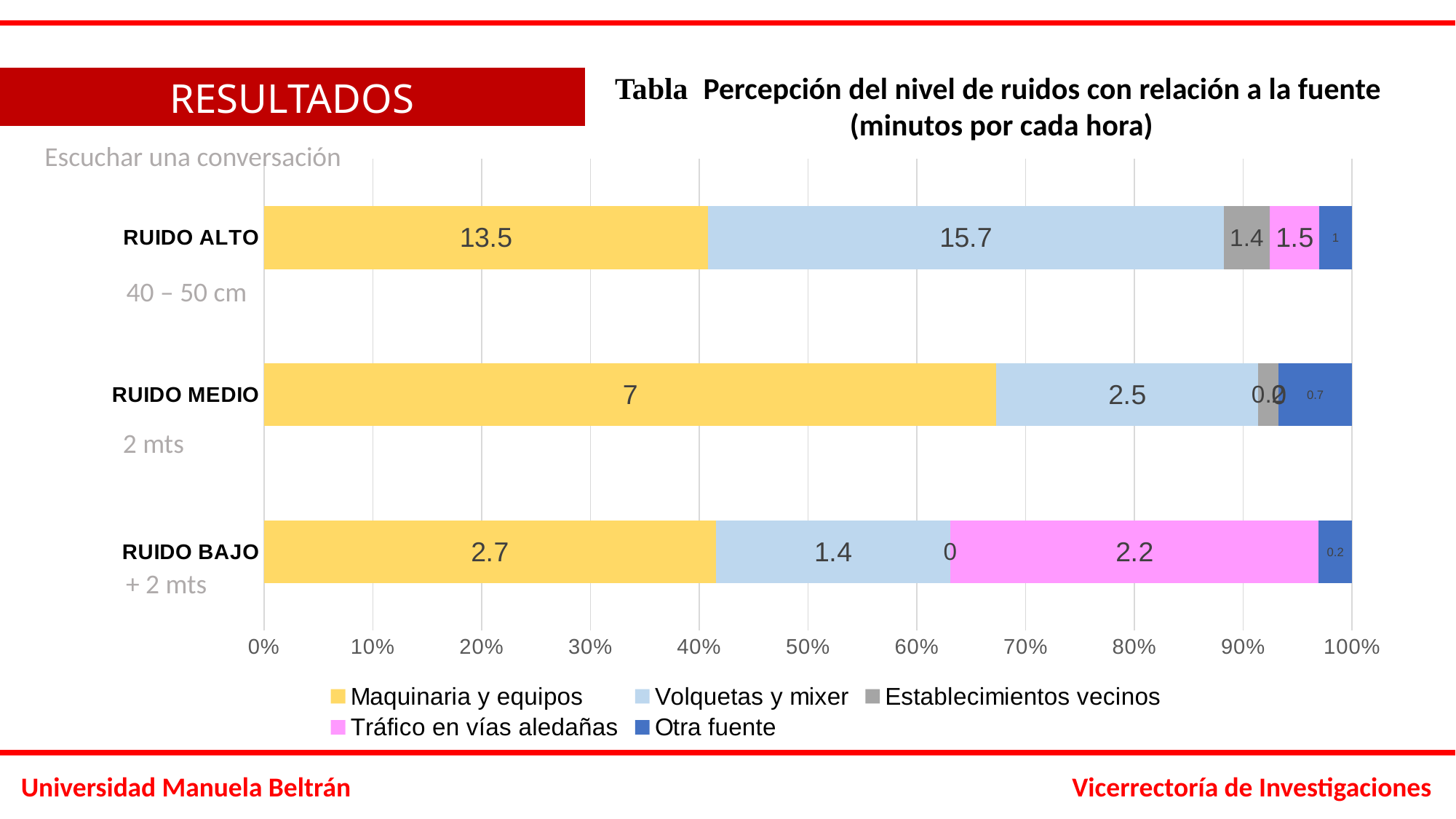
Which noise level category has the highest value for Maquinaria y equipos? RUIDO ALTO How many noise level categories are shown on the chart? 3 In the RUIDO ALTO bar, which is larger: Volquetas y mixer or Maquinaria y equipos? Volquetas y mixer How many series does the legend list? 5 What is the value for Maquinaria y equipos in the RUIDO ALTO bar? 13.5 What is the value for Tráfico en vías aledañas in the RUIDO BAJO bar? 2.2 What is the total of all the labelled values in the RUIDO ALTO bar? 33.1 What kind of chart is shown on the slide? Stacked bar chart What is the value for Volquetas y mixer in the RUIDO ALTO bar? 15.7 In the RUIDO ALTO bar, what is the difference between the Volquetas y mixer value and the Maquinaria y equipos value? 2.2 What is the value for Maquinaria y equipos in the RUIDO MEDIO bar? 7 Is the share of the RUIDO MEDIO bar taken by Maquinaria y equipos greater or less than 60%? greater